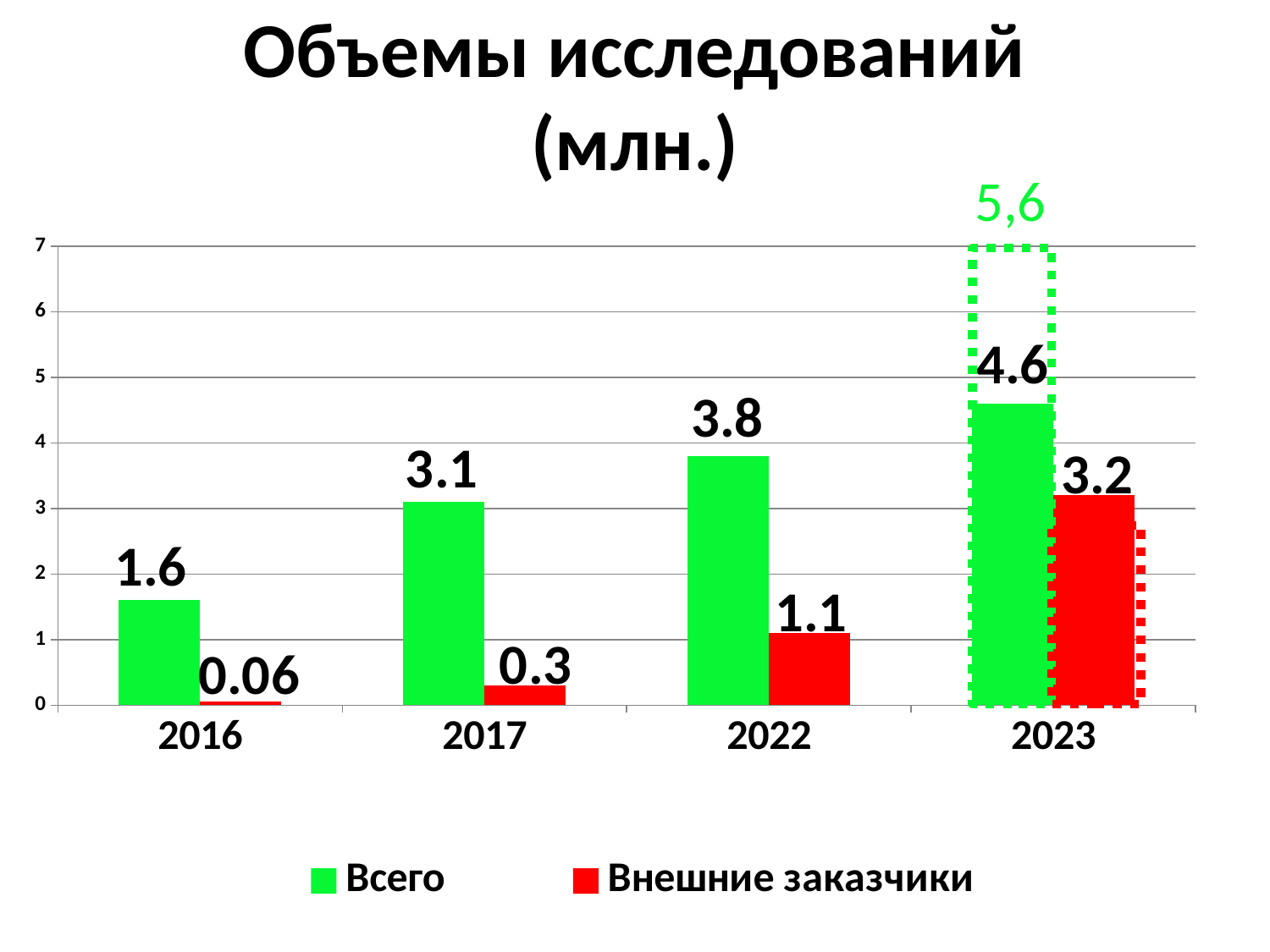
How many years are shown on the x axis? 4 What kind of chart is shown? bar chart What is the value of Всего for 2022? 3.8 Is the value of Всего for 2016 greater or less than 2? less What is the value of Внешние заказчики for 2023? 3.2 What is the difference between Всего and Внешние заказчики in 2017? 2.8 Does the value of Всего rise or fall from 2016 to 2023? rise Which year has the lowest value for Внешние заказчики? 2016 What is the value of Внешние заказчики for 2016? 0.06 How many series does the legend list? 2 Which year has the highest value for Всего? 2023 Which is larger in 2022: Всего or Внешние заказчики? Всего